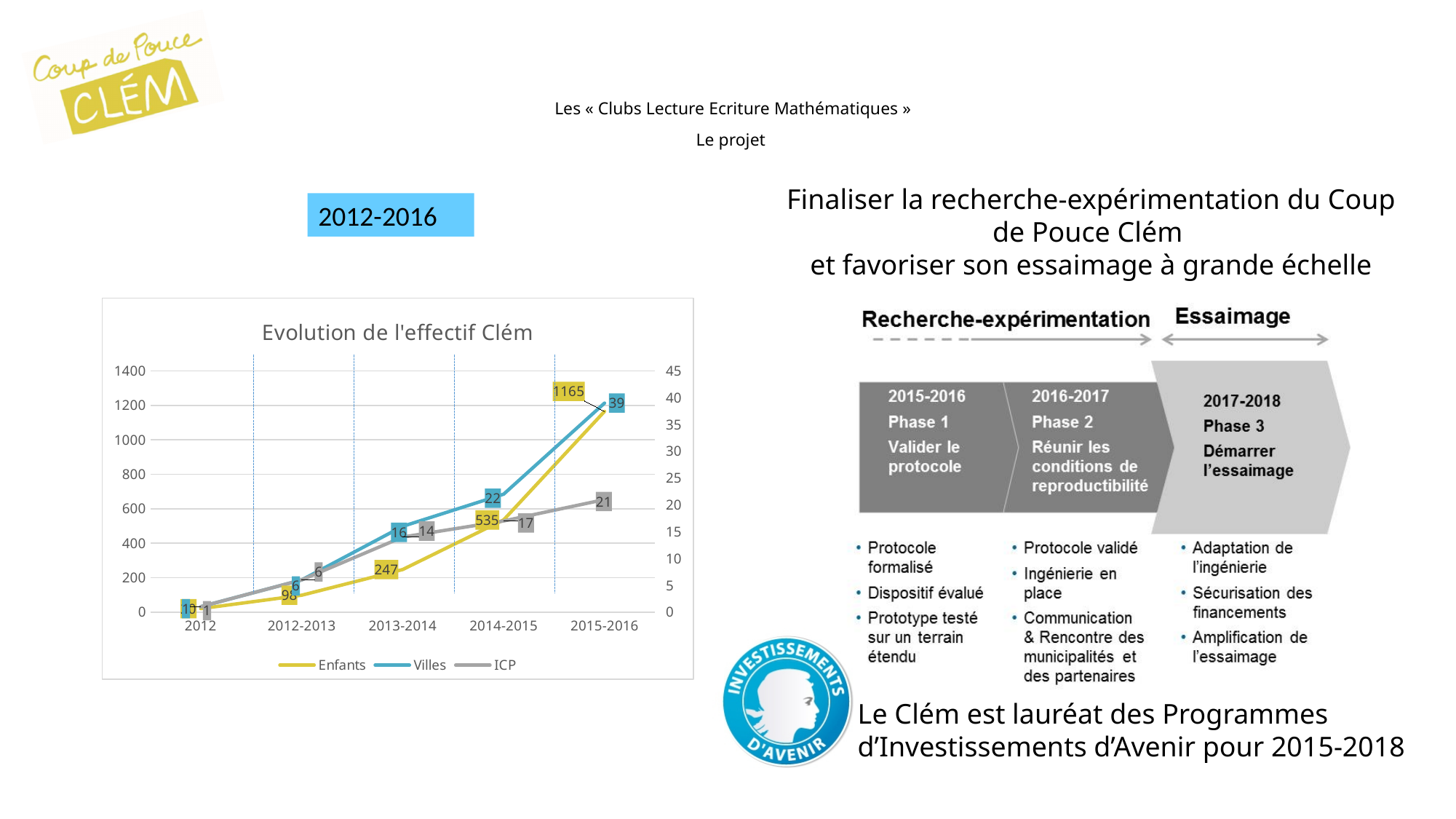
What is the title of the chart? Evolution de l'effectif Clém By how much did the Enfants value increase from 2014-2015 to 2015-2016? 630 Do the Enfants values rise or fall from 2012 to 2015-2016? Rise What is the value for Enfants in 2015-2016? 1165 In 2014-2015, which is larger, Villes or ICP? Villes What kind of chart is shown on the slide? Line chart What is the value for ICP in 2015-2016? 21 How many periods are shown on the x axis of the chart? 5 What is the value for Enfants in 2014-2015? 535 What is the value for Villes in 2015-2016? 39 What is the value for Enfants in 2013-2014? 247 How many series does the legend of the chart list? 3